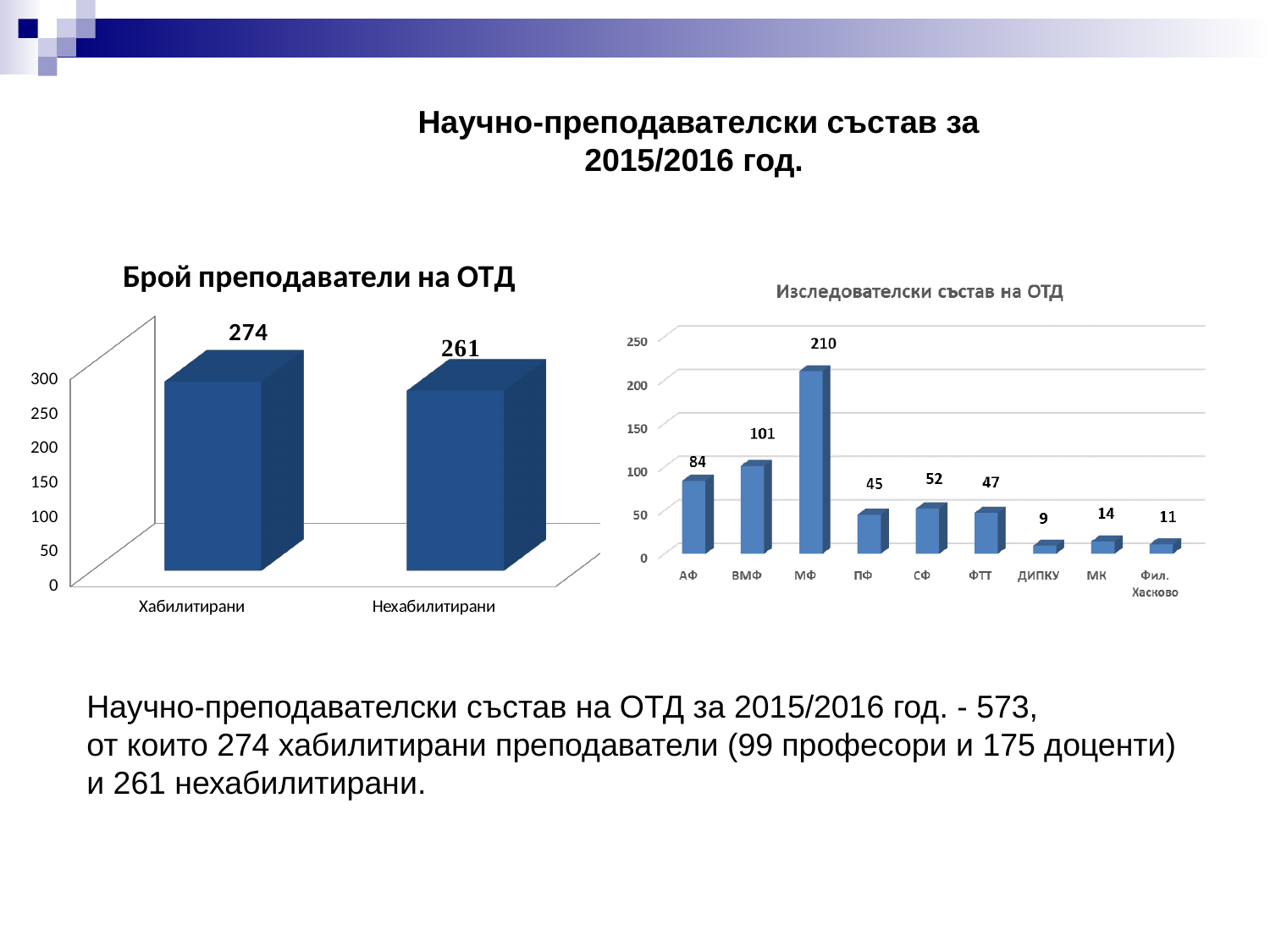
In the chart titled "Изследователски състав на ОТД", which is larger, СФ or ФТТ? СФ In the chart titled "Изследователски състав на ОТД", how many categories are shown on the x axis? 9 In the chart titled "Изследователски състав на ОТД", what is the value for ВМФ? 101 In the chart titled "Изследователски състав на ОТД", which category has the lowest value? ДИПКУ In the chart titled "Изследователски състав на ОТД", which category has the highest value? МФ In the chart titled "Брой преподаватели на ОТД", what is the value for Хабилитирани? 274 In the chart titled "Брой преподаватели на ОТД", what is the value for Нехабилитирани? 261 In the chart titled "Изследователски състав на ОТД", what is the difference between АФ and ПФ? 39 In the chart titled "Брой преподаватели на ОТД", what is the difference between Хабилитирани and Нехабилитирани? 13 What kind of chart is the chart titled "Изследователски състав на ОТД"? Bar chart In the chart titled "Изследователски състав на ОТД", what is the value for МФ? 210 In the chart titled "Брой преподаватели на ОТД", how many categories are shown? 2